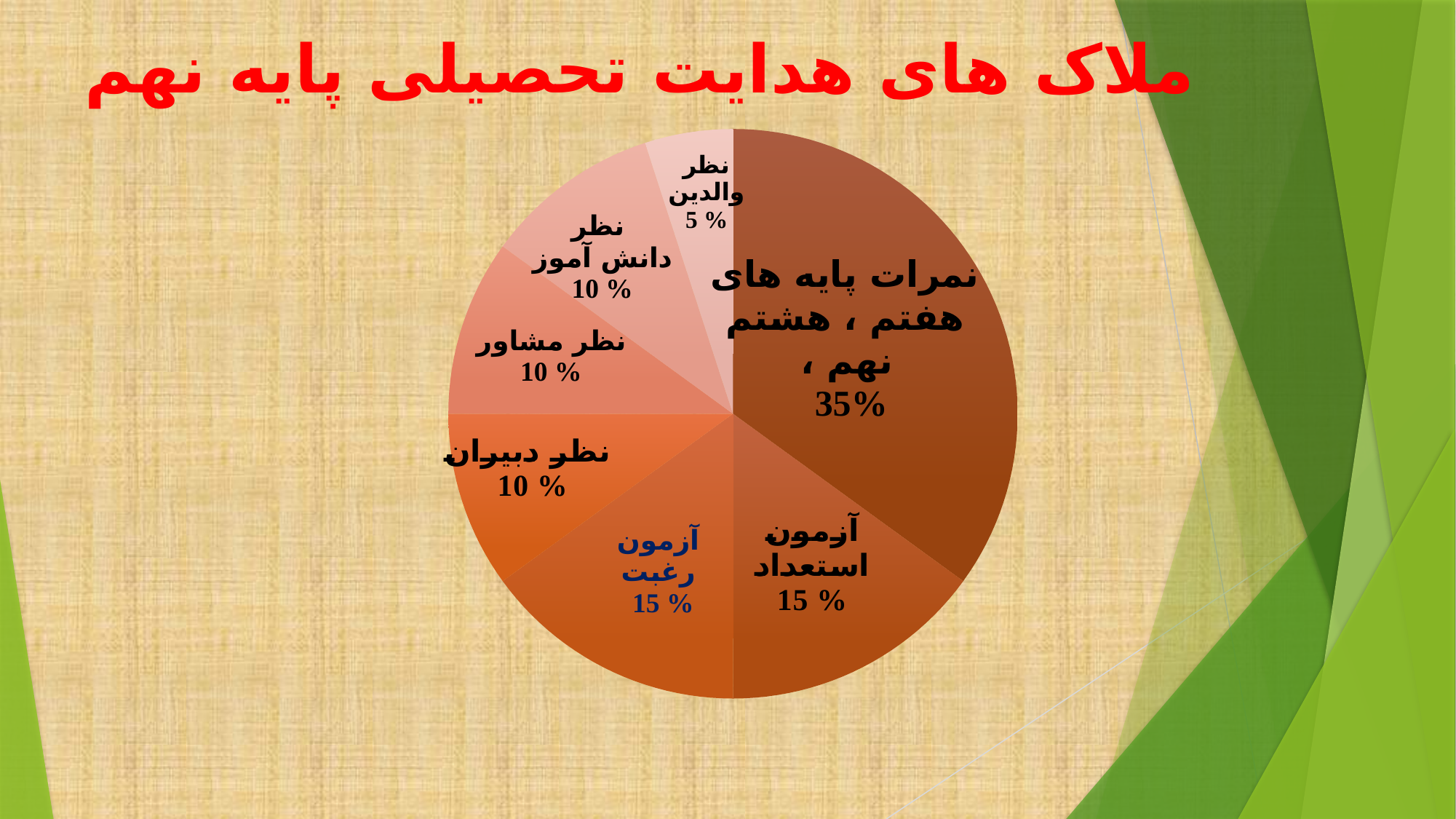
What kind of chart is shown on the slide? pie chart Which slice of the pie chart is the largest? نمرات پایه های هفتم ، هشتم ، نهم Which slice of the pie chart is the smallest? نظر والدین What is the title of the slide containing the pie chart? ملاک های هدایت تحصیلی پایه نهم What is the value shown for the slice labelled نمرات پایه های هفتم ، هشتم ، نهم? 35% What is the value shown for the slice labelled نظر مشاور? 10 % What is the value shown for the slice labelled آزمون استعداد? 15 % What is the difference between the values for نمرات پایه های هفتم ، هشتم ، نهم and آزمون رغبت? 20% What is the value shown for the slice labelled نظر والدین? 5 % How many slices does the pie chart have? 7 What share of the pie do the slices آزمون استعداد and آزمون رغبت make up together? 30% Which is larger, the value for نظر دبیران or the value for نظر والدین? نظر دبیران